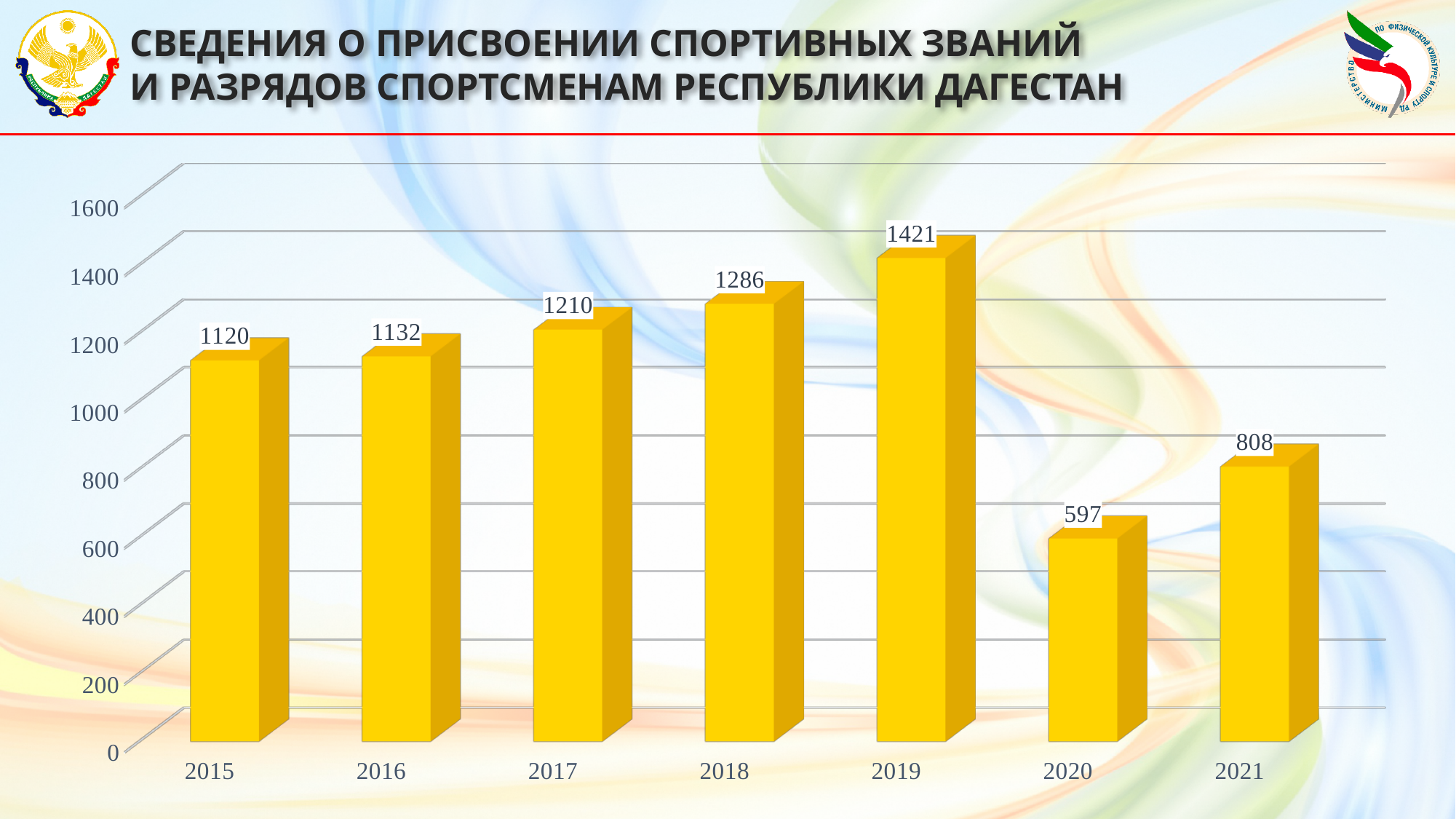
Which year has the highest value? 2019 What is the difference between the values for 2019 and 2020? 824 How many years are shown on the chart? 7 What is the value for 2021? 808 What is the difference between the values for 2018 and 2017? 76 What is the value for 2020? 597 Which year has the lowest value? 2020 What is the value for 2019? 1421 Which is larger, the value for 2016 or the value for 2021? 2016 Do the values rise or fall from 2015 to 2019? rise What is the value for 2015? 1120 What kind of chart is shown on the slide? bar chart